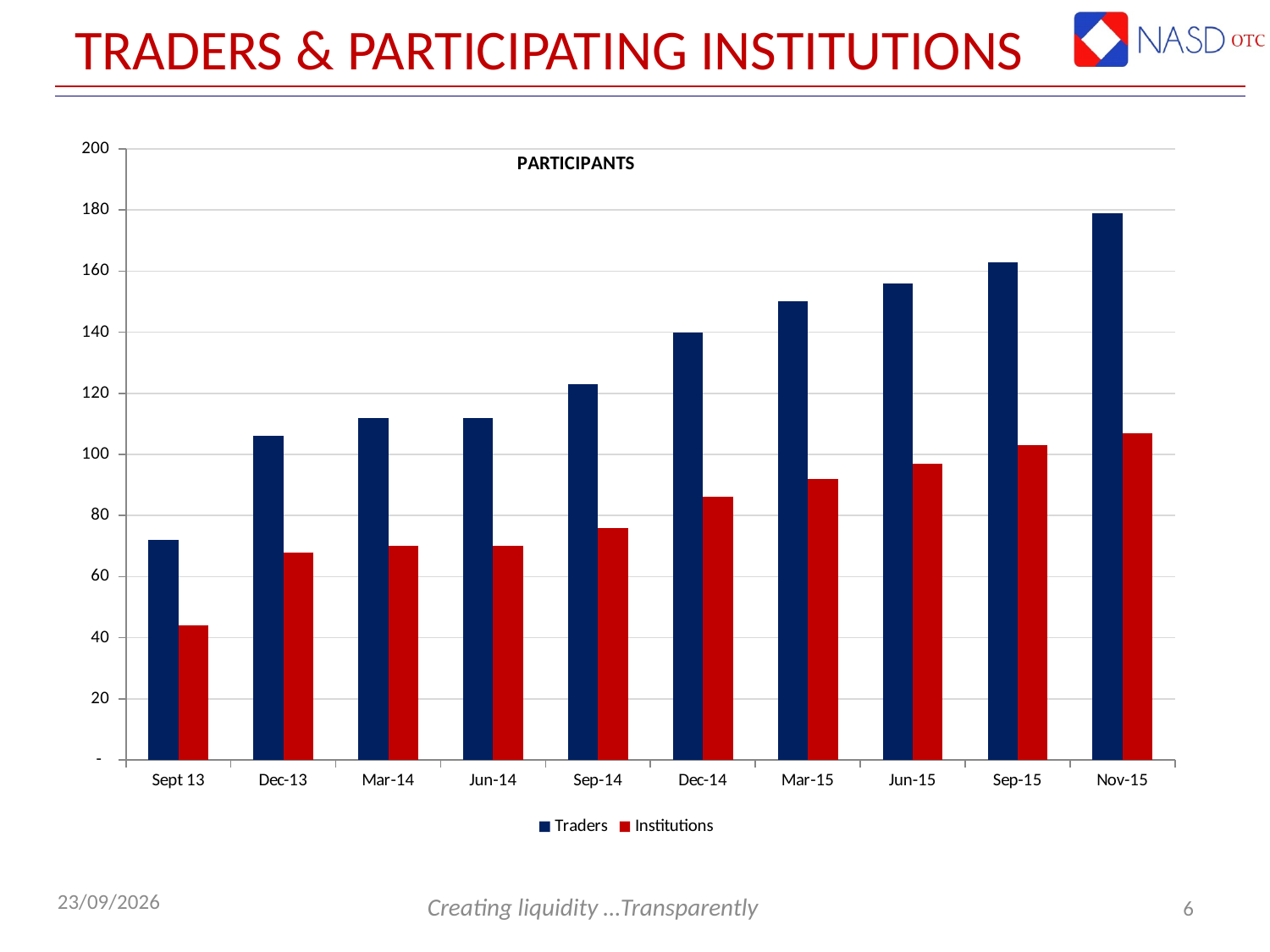
In which period is the Institutions value lowest? Sept 13 What is the title printed inside the chart area? PARTICIPANTS For Sept 13, which is larger, Traders or Institutions? Traders What kind of chart is shown on the slide? Bar chart In which period is the Traders value highest? Nov-15 Is the Traders value for Nov-15 greater or less than 160? greater Which series is shown in red? Institutions How many series does the legend list? 2 Do the Traders values generally rise or fall from Sept 13 to Nov-15? Rise How many time periods are shown on the x axis? 10 Is the Institutions value for Sept 13 greater or less than 60? less Is the Traders value for Mar-15 greater or less than 140? greater